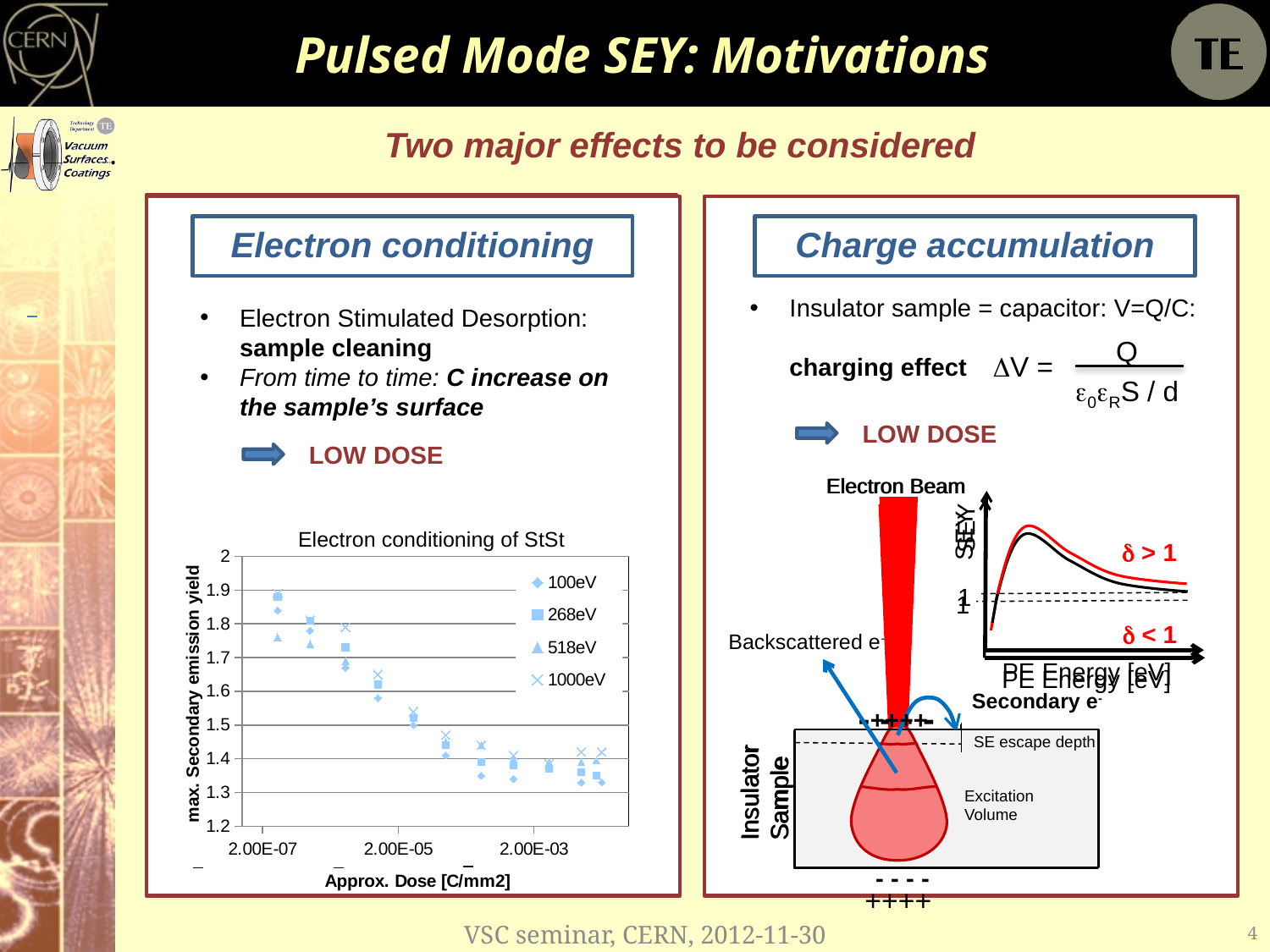
In the 'Electron conditioning of StSt' chart, are the values at the highest dose greater or less than 1.5? less In the 'Electron conditioning of StSt' chart, do the secondary emission yield values rise or fall as the dose increases? fall In the 'Electron conditioning of StSt' chart, is the 518eV value at the lowest dose greater or less than 1.7? greater In the 'Electron conditioning of StSt' chart, is the highest value of the 100eV series greater or less than 1.8? greater Which series are listed in the legend of the 'Electron conditioning of StSt' chart? 100eV, 268eV, 518eV, 1000eV In the 'Electron conditioning of StSt' chart, at the lowest dose, which series has the higher value, 100eV or 518eV? 100eV How many series does the legend of the 'Electron conditioning of StSt' chart list? 4 What kind of chart is 'Electron conditioning of StSt'? scatter chart What is the title of the chart on the left side of the slide? Electron conditioning of StSt